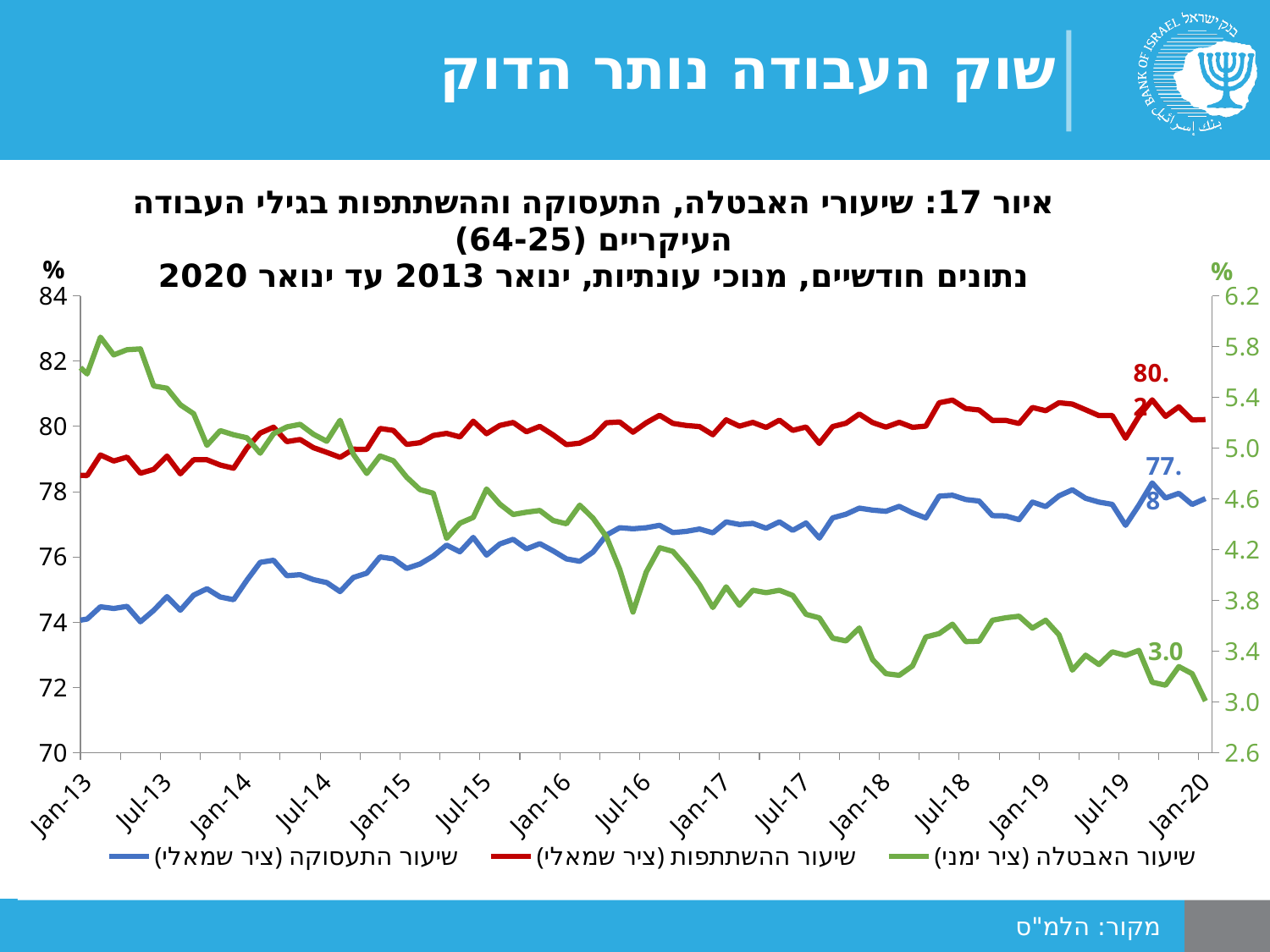
What type of chart is shown on the slide? line chart What is the last data label shown for the participation rate (שיעור ההשתתפות) series? 80.2 What is the difference between the final labelled values of the participation rate (80.2) and the employment rate (77.8)? 2.4 Does the unemployment rate (green line) generally rise or fall from Jan-13 to Jan-20? fall At the end of the series, which is higher: the participation rate or the employment rate? participation rate What is the last data label shown for the unemployment rate (שיעור האבטלה) series? 3.0 Does the employment rate (blue line) generally rise or fall from Jan-13 to Jan-20? rise Is the employment rate at Jan-13 greater or less than 76 on the left axis? less What is the last data label shown for the employment rate (שיעור התעסוקה) series? 77.8 Is the unemployment rate at Jan-13 greater or less than 5.0 on the right axis? greater Which series is plotted on the right axis according to the legend? שיעור האבטלה (unemployment rate) How many series does the legend list? 3